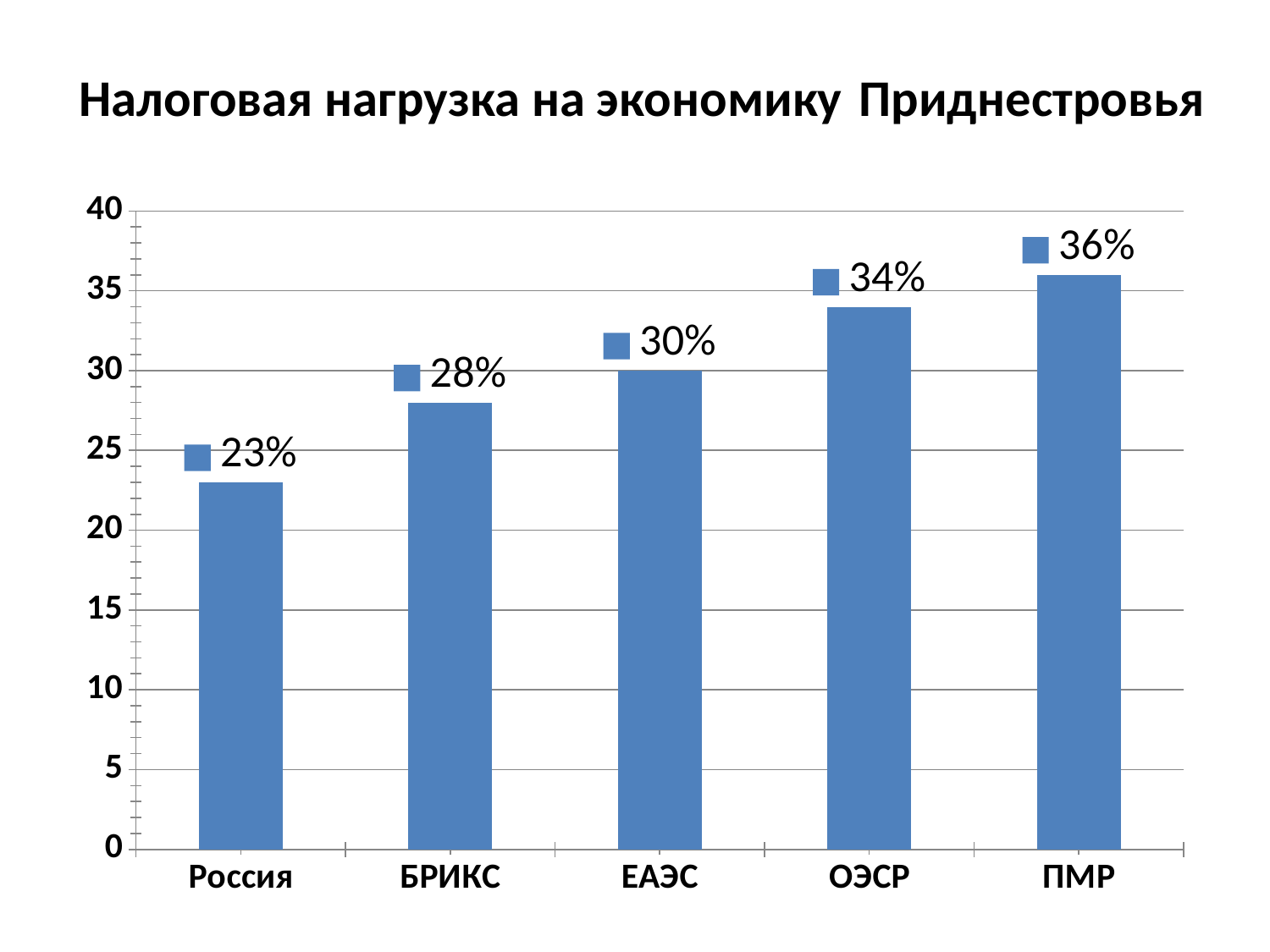
Which category has the highest value? ПМР Do the values rise or fall from left to right along the x axis? rise What is the difference between the values for ОЭСР and БРИКС? 6% Which category has the lowest value? Россия What is the value for Россия? 23% Which is larger, the value for БРИКС or the value for ЕАЭС? ЕАЭС Is the value for ОЭСР greater or less than 30? greater How many categories are shown on the x axis? 5 What is the difference between the values for ПМР and Россия? 13% What is the value for ПМР? 36% What is the value for ЕАЭС? 30% What kind of chart is shown on the slide? bar chart